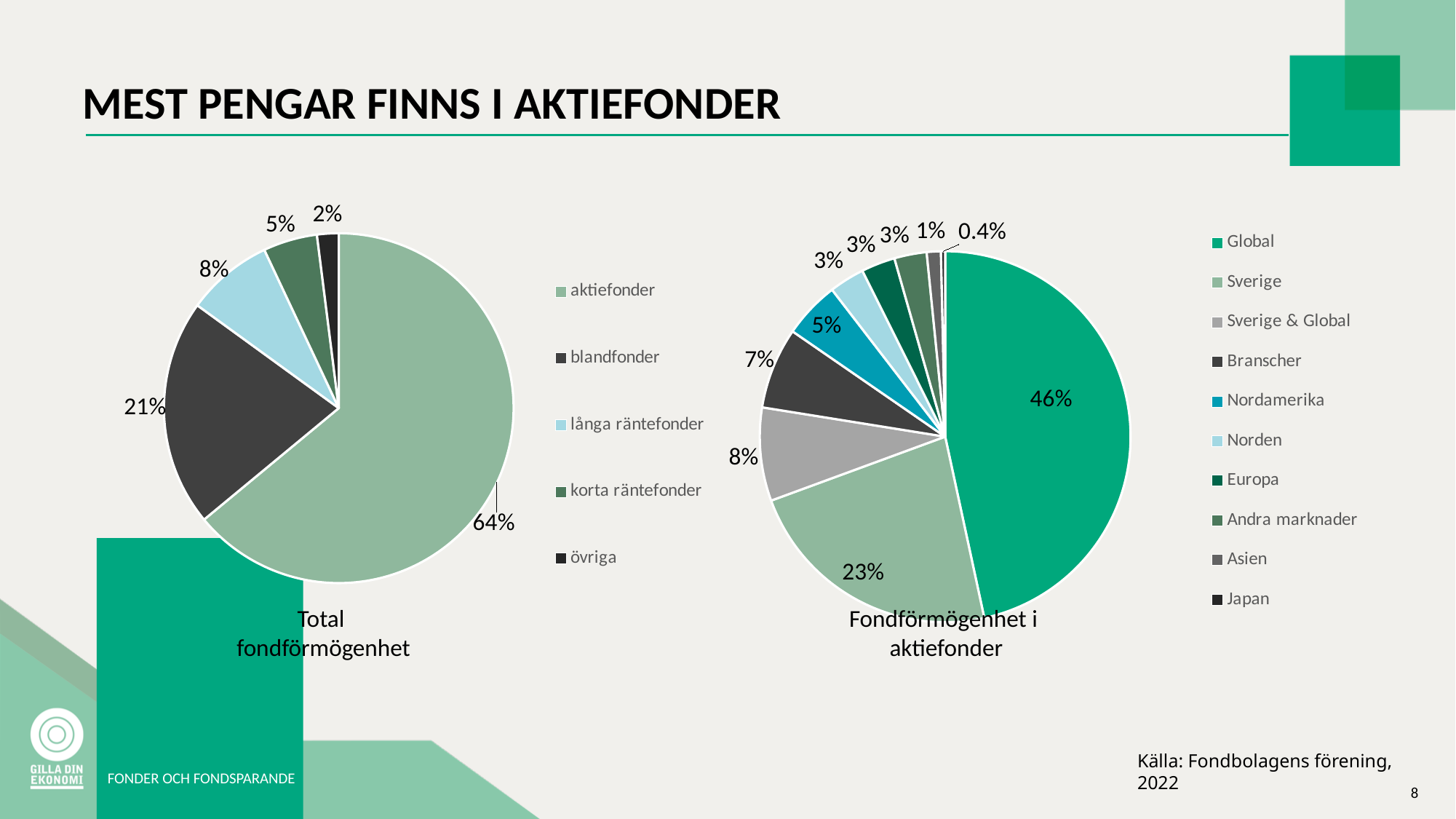
What type of chart is used for 'Fondförmögenhet i aktiefonder'? Pie chart In the 'Fondförmögenhet i aktiefonder' pie chart, what share is Global? 46% In the 'Fondförmögenhet i aktiefonder' pie chart, what share is Sverige? 23% In the 'Total fondförmögenhet' pie chart, what is the difference between the shares of långa räntefonder and korta räntefonder? 3 percentage points In the 'Total fondförmögenhet' pie chart, what share is blandfonder? 21% In the 'Total fondförmögenhet' pie chart, what share is aktiefonder? 64% In the 'Fondförmögenhet i aktiefonder' pie chart, which is larger, Sverige & Global or Branscher? Sverige & Global In the 'Fondförmögenhet i aktiefonder' pie chart, which category has the largest share? Global How many categories does the legend of the 'Fondförmögenhet i aktiefonder' chart list? 10 In the 'Fondförmögenhet i aktiefonder' pie chart, what share is Japan? 0.4% In the 'Total fondförmögenhet' pie chart, which category has the smallest share? övriga How many categories does the legend of the 'Total fondförmögenhet' chart list? 5